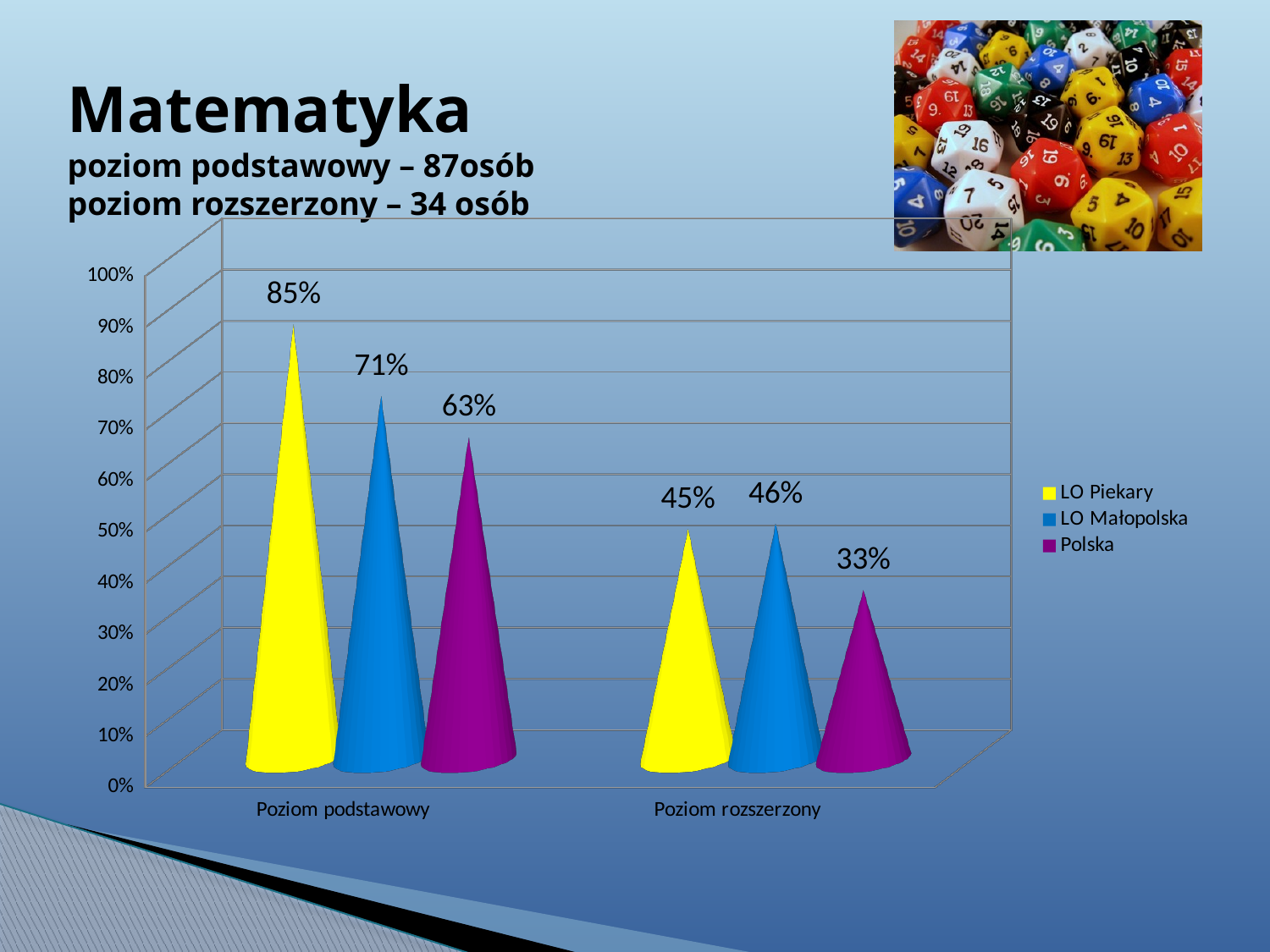
Which is larger: LO Małopolska at Poziom podstawowy or LO Małopolska at Poziom rozszerzony? Poziom podstawowy What is the value for LO Małopolska at Poziom rozszerzony? 46% What is the difference between LO Małopolska and Polska at Poziom rozszerzony? 13% How many series does the legend list? 3 What kind of chart is shown on the slide? Bar chart What is the value for LO Piekary at Poziom podstawowy? 85% How many categories are shown on the x axis? 2 What is the value for Polska at Poziom rozszerzony? 33% Which colour represents Polska in the legend? Purple What is the difference between LO Piekary and Polska at Poziom podstawowy? 22% Which series has the lowest value at Poziom rozszerzony? Polska Which series has the highest value at Poziom podstawowy? LO Piekary